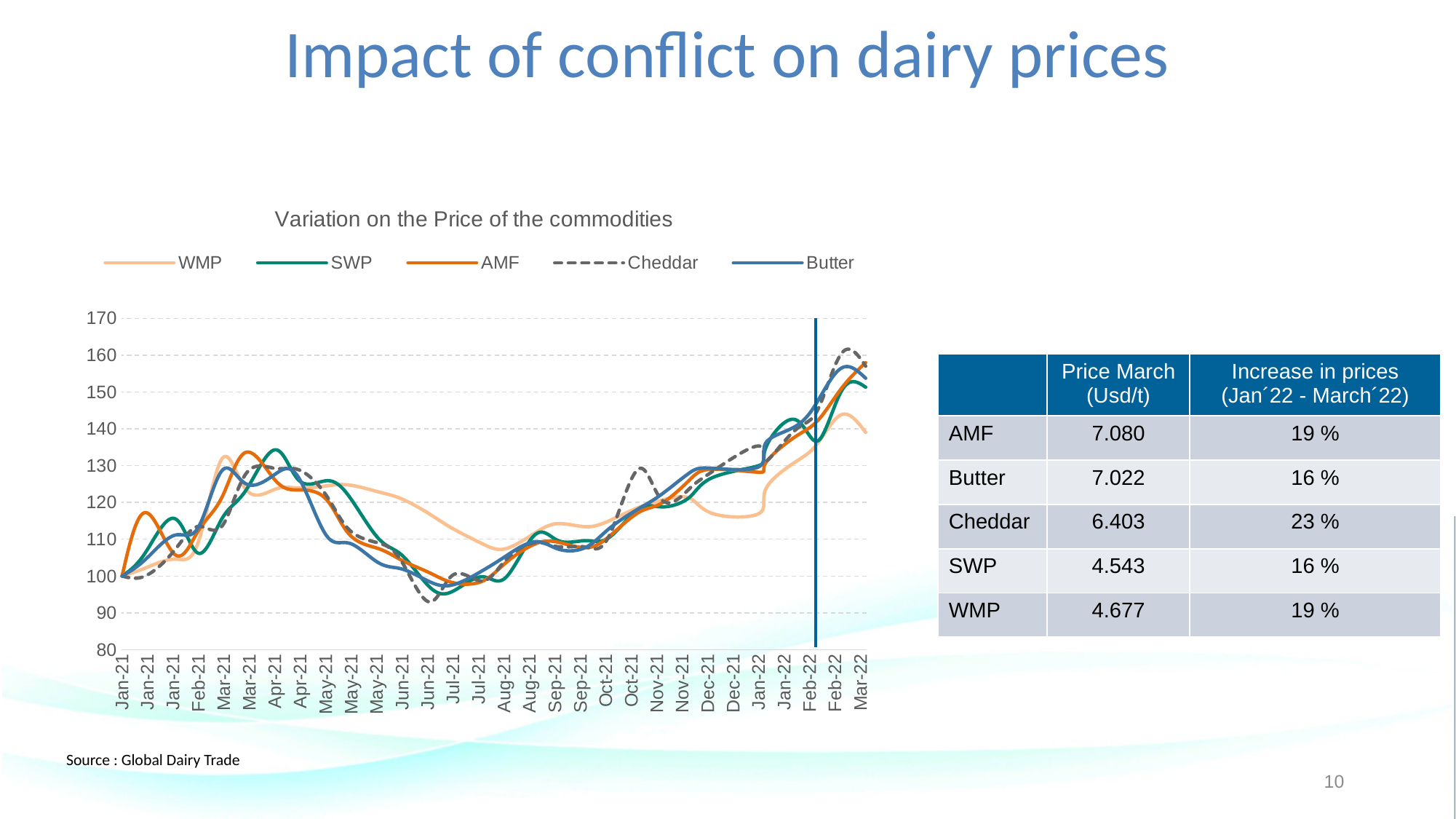
From Jul-21 to Mar-22, do the values in the chart generally rise or fall? rise At Jan-21, what value do all the series in the chart start from? 100 At Mar-22, is the value for WMP higher or lower than the value for Cheddar? lower What kind of chart is shown on the slide? line chart Which series reaches the highest value anywhere on the chart? Cheddar Which series in the chart is drawn with a dashed line? Cheddar How many series does the legend of the chart list? 5 Which series reaches the lowest value anywhere on the chart? Cheddar Is the value for WMP at Mar-22 greater or less than 130? greater What is the title of the chart? Variation on the Price of the commodities